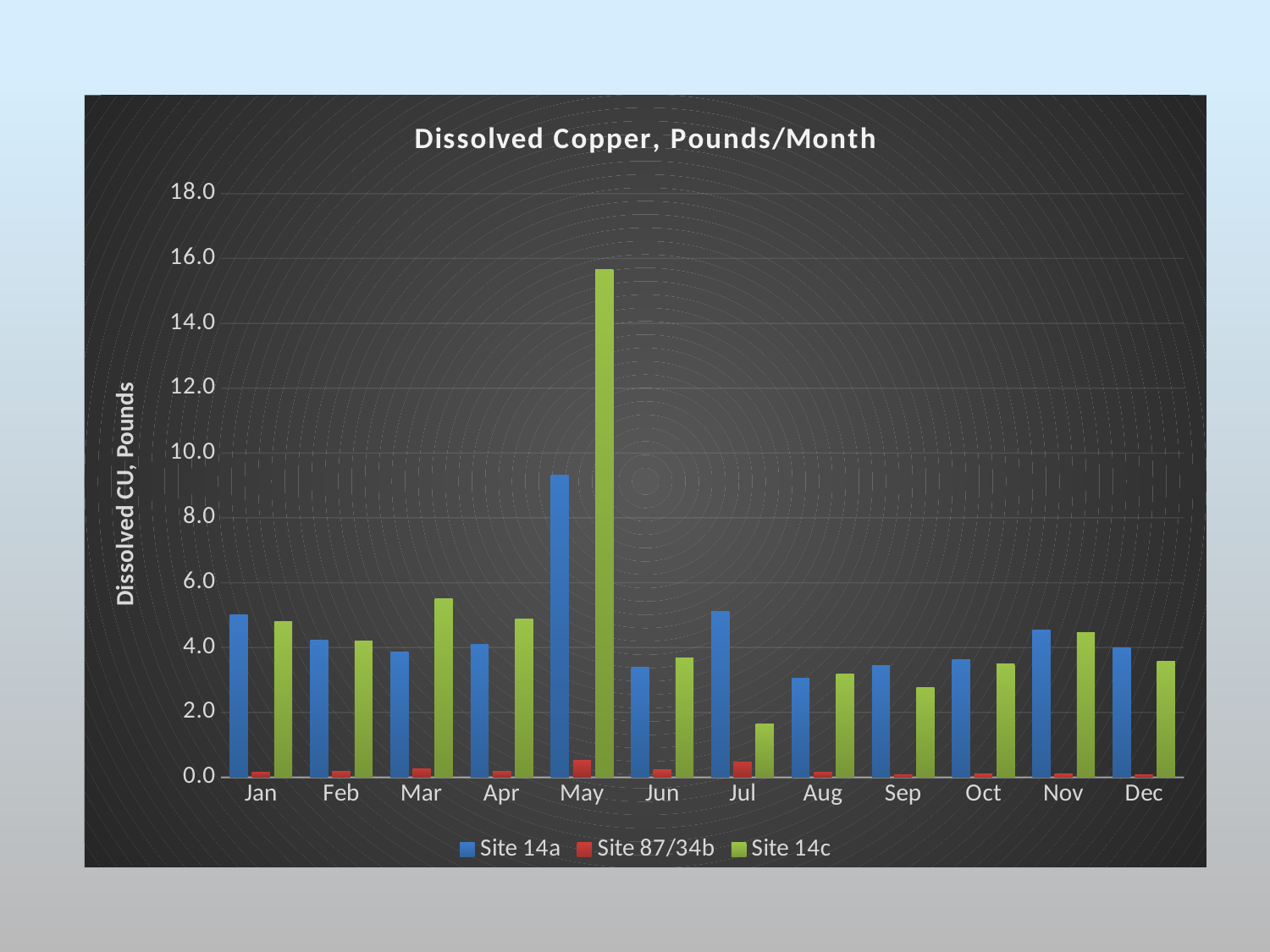
What kind of chart is shown on the slide? bar chart How many months are shown on the x axis? 12 In Mar, which is larger: Site 14a or Site 14c? Site 14c Is the Site 14a value for May greater or less than 8.0? greater In which month is the Site 14c value lowest? Jul In which month is the Site 14a value highest? May In Jul, which is larger: Site 14a or Site 14c? Site 14a In which month is the Site 14c value highest? May What is the title of the chart? Dissolved Copper, Pounds/Month Is the Site 14c value for May greater or less than 14.0? greater How many series does the legend list? 3 Is the Site 14c value for Jul greater or less than 2.0? less